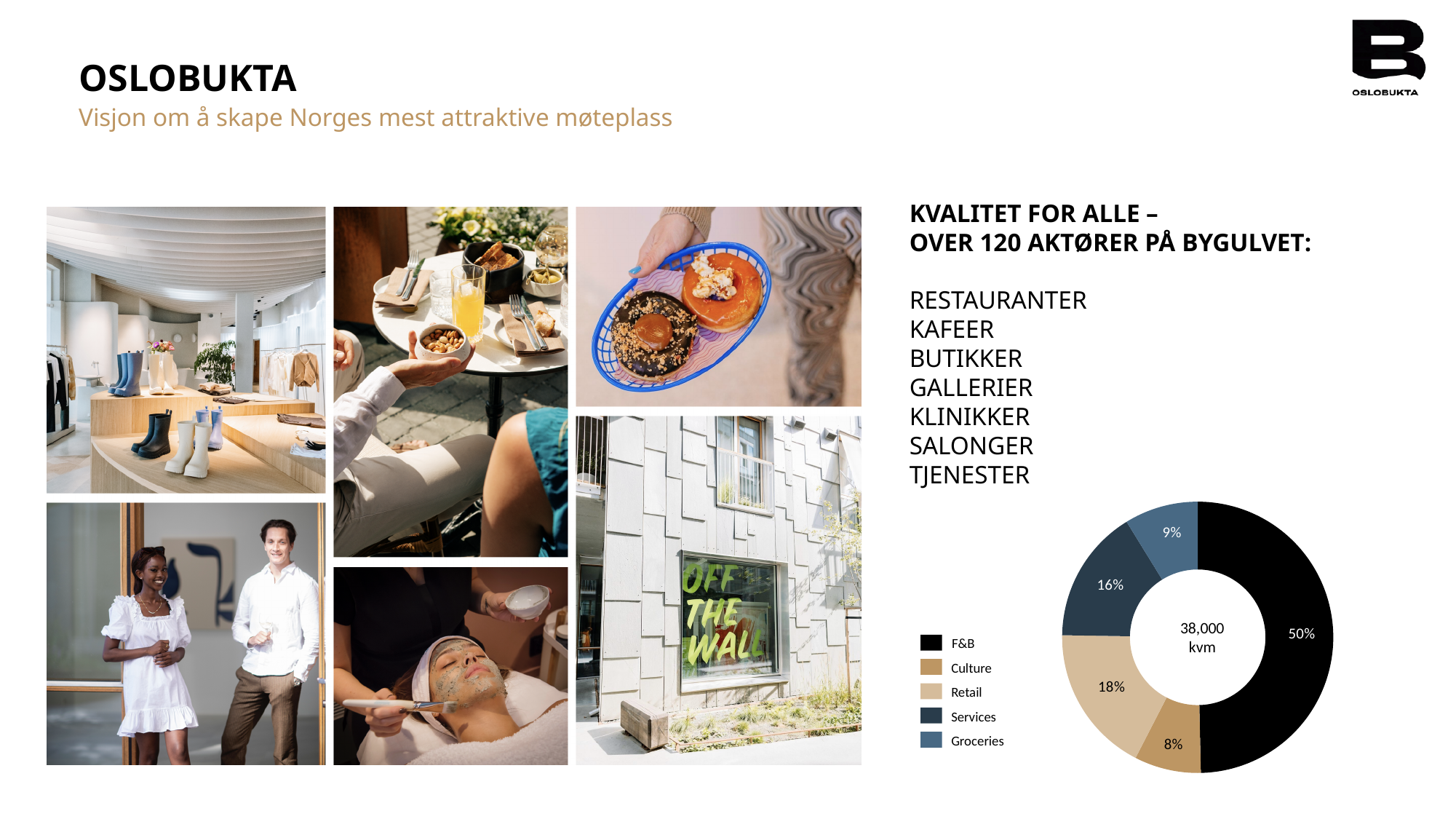
What share of the donut chart does Services account for? 16% What share of the donut chart does Groceries account for? 9% What share of the donut chart does F&B account for? 50% What text is shown in the centre of the donut chart? 38,000 kvm Which category has the smallest share in the donut chart? Culture How many categories does the donut chart's legend list? 5 What share of the donut chart does Culture account for? 8% What kind of chart is shown on the slide? Donut chart Which has a larger share in the donut chart, Groceries or Culture? Groceries What is the difference in percentage points between the Retail and Services shares in the donut chart? 2 Which category has the largest share in the donut chart? F&B What share of the donut chart does Retail account for? 18%